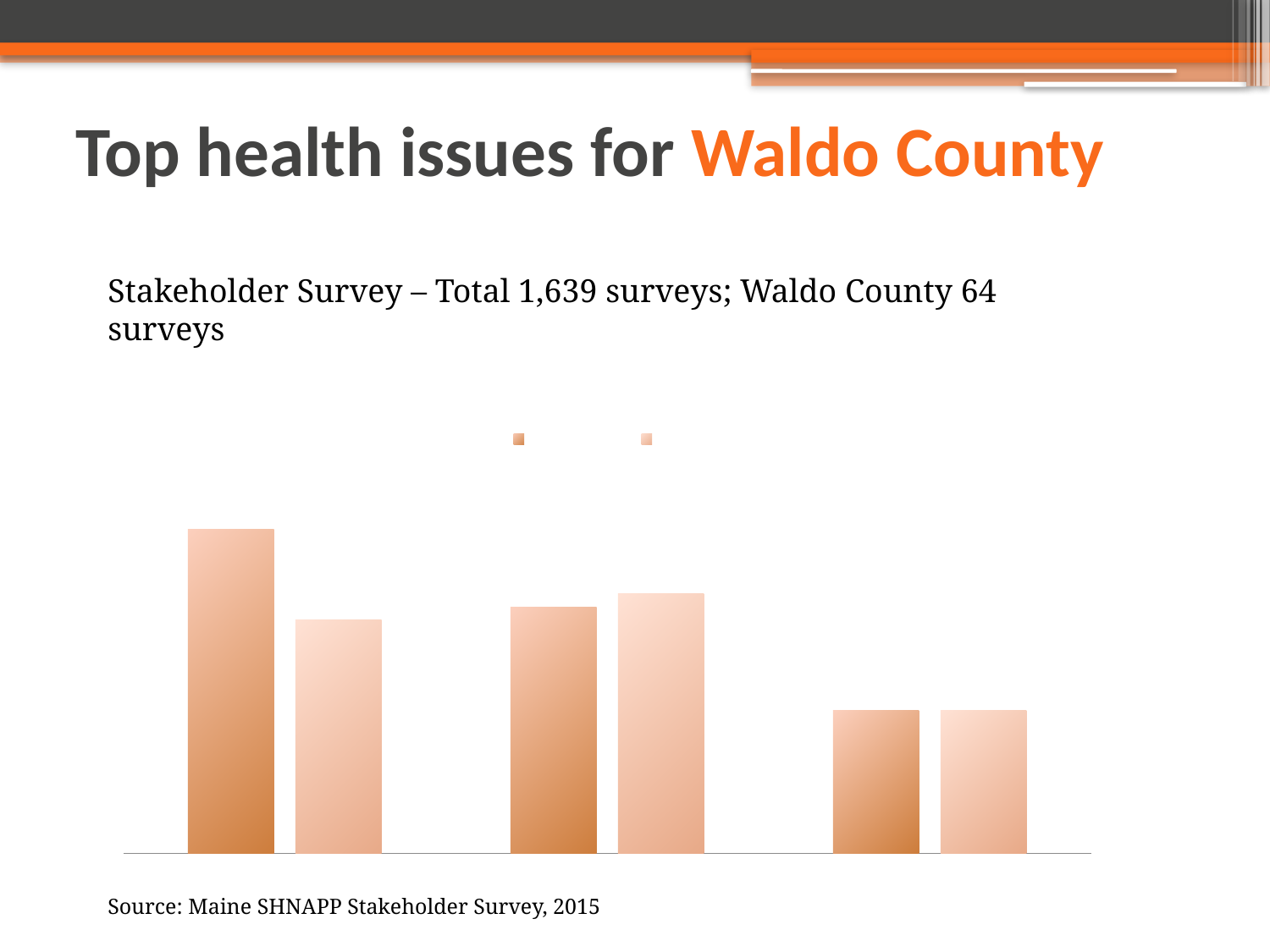
What source is cited below the chart? Maine SHNAPP Stakeholder Survey, 2015 What kind of chart is shown on the slide? bar chart Do the darker bars rise or fall from left to right across the chart? fall How many groups of bars (categories) does the chart show? 3 Which group of bars has the shortest bars in the chart: the leftmost, middle, or rightmost? rightmost What colour scheme are the bars in the chart? orange Which group of bars contains the tallest bar in the chart: the leftmost, middle, or rightmost? leftmost In the leftmost group, which bar is taller: the darker bar or the lighter bar? the darker bar How many bars are plotted in the chart? 6 Is the darker bar in the leftmost group taller or shorter than the darker bar in the rightmost group? taller How many series does the chart's legend list? 2